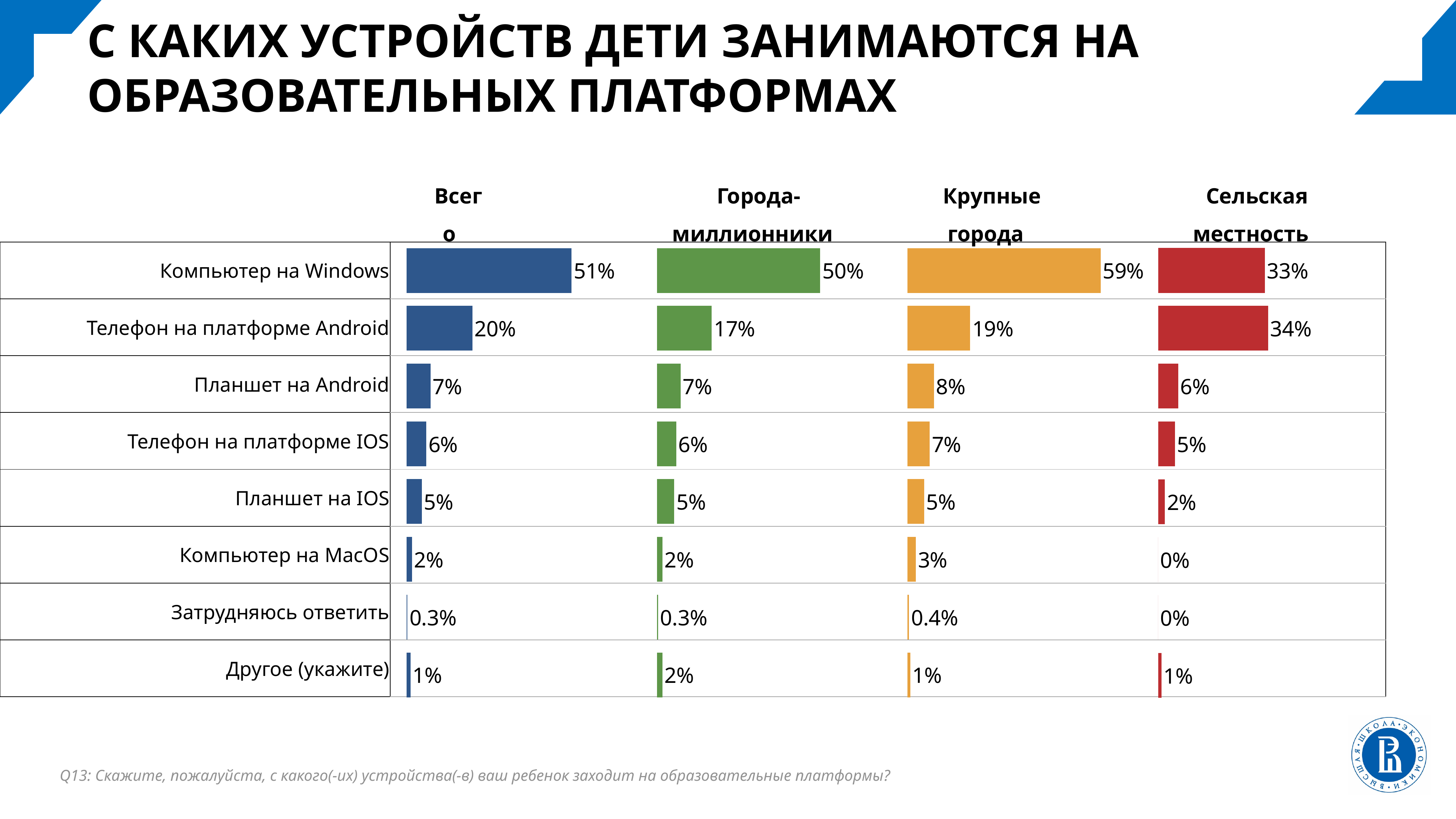
Which is larger: "Компьютер на Windows" in the "Города-миллионники" chart or "Компьютер на Windows" in the "Сельская местность" chart? Города-миллионники In the "Сельская местность" chart, what is the value for "Телефон на платформе Android"? 34% In the "Сельская местность" chart, what is the difference between "Планшет на Android" and "Планшет на IOS"? 4% In the "Крупные города" chart, which category has the highest value? Компьютер на Windows In the "Города-миллионники" chart, what is the value for "Затрудняюсь ответить"? 0.3% In the "Сельская местность" chart, which category has the highest value? Телефон на платформе Android In the "Всего" chart, what is the value for "Компьютер на Windows"? 51% What type of chart is used for the "Города-миллионники" data? Bar chart In the "Крупные города" chart, what is the value for "Компьютер на MacOS"? 3% How many categories are shown in the "Всего" chart? 8 In the "Крупные города" chart, what is the difference between "Компьютер на Windows" and "Телефон на платформе Android"? 40% In the "Всего" chart, which category has the lowest value? Затрудняюсь ответить